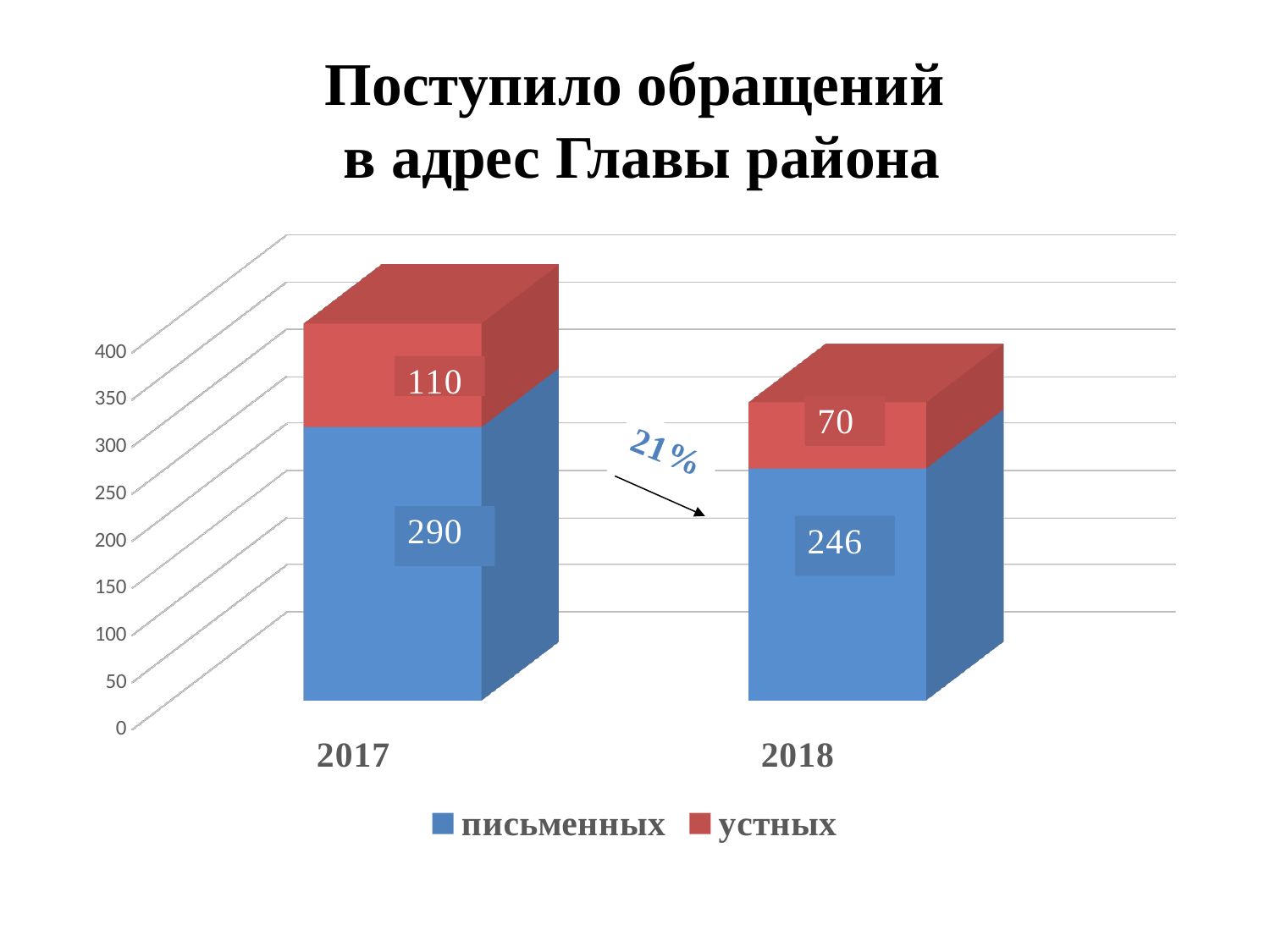
What is the total of the stacked bar for 2017? 400 What is the value for письменных in 2017? 290 What is the total of the stacked bar for 2018? 316 What is the value for устных in 2017? 110 What percentage change is annotated between the 2017 and 2018 bars? 21% What kind of chart is shown on the slide? Stacked bar chart What is the value for устных in 2018? 70 What is the value for письменных in 2018? 246 How many categories are shown on the x axis? 2 What is the difference between письменных in 2017 and письменных in 2018? 44 How many series does the legend list? 2 Which year has the higher value for устных, 2017 or 2018? 2017